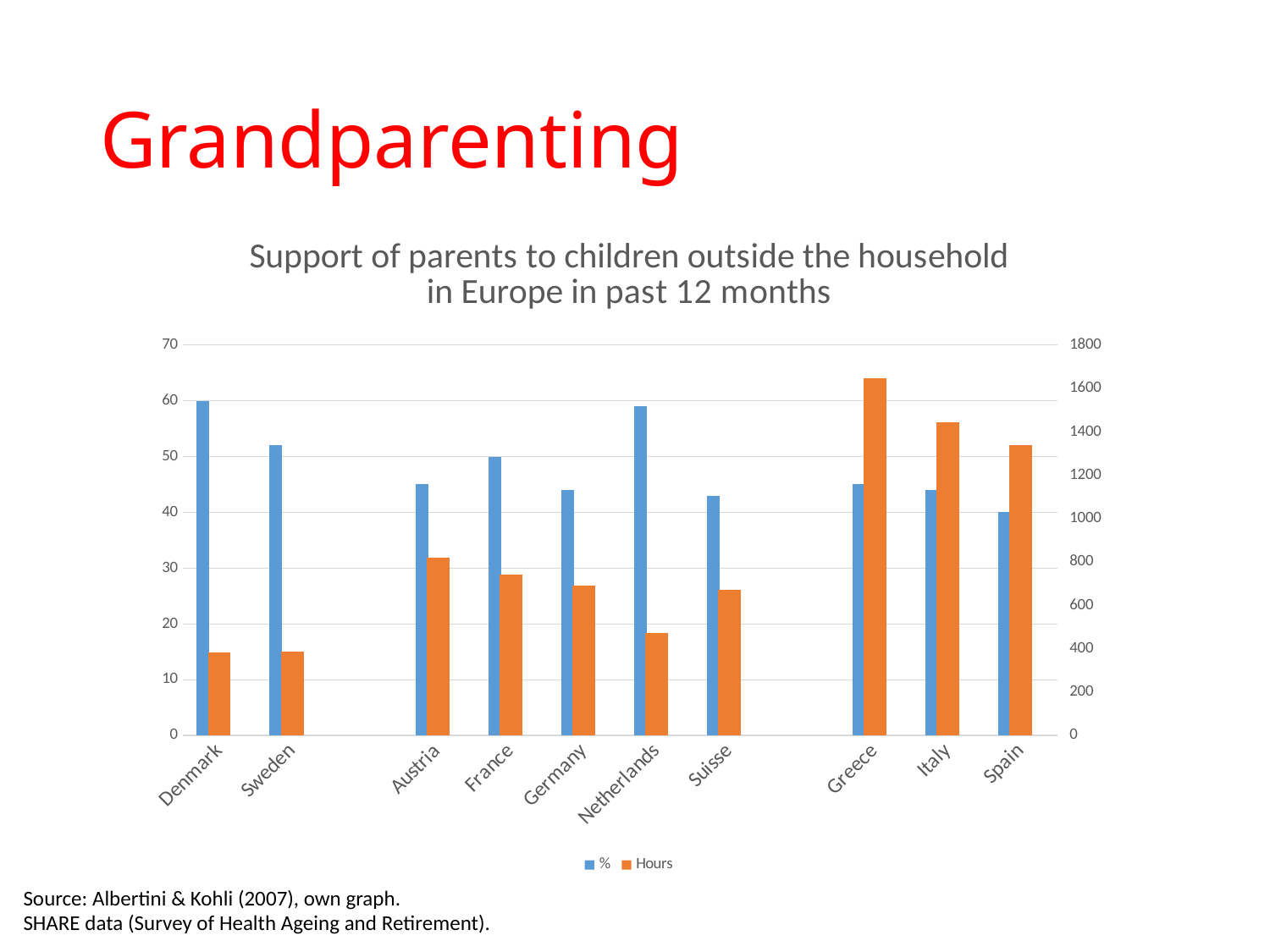
Is the % value for Suisse greater or less than 50? less Is the Hours value for Greece greater or less than 1600? greater Which has the larger % value, France or Germany? France How many countries are shown on the x axis of the chart? 10 Is the Hours value for Netherlands greater or less than 600? less Which has the larger Hours value, Greece or Italy? Greece What kind of chart is shown on the slide? bar chart Which country has the highest value for Hours? Greece How many series does the chart's legend list? 2 What are the two series named in the chart's legend? % and Hours